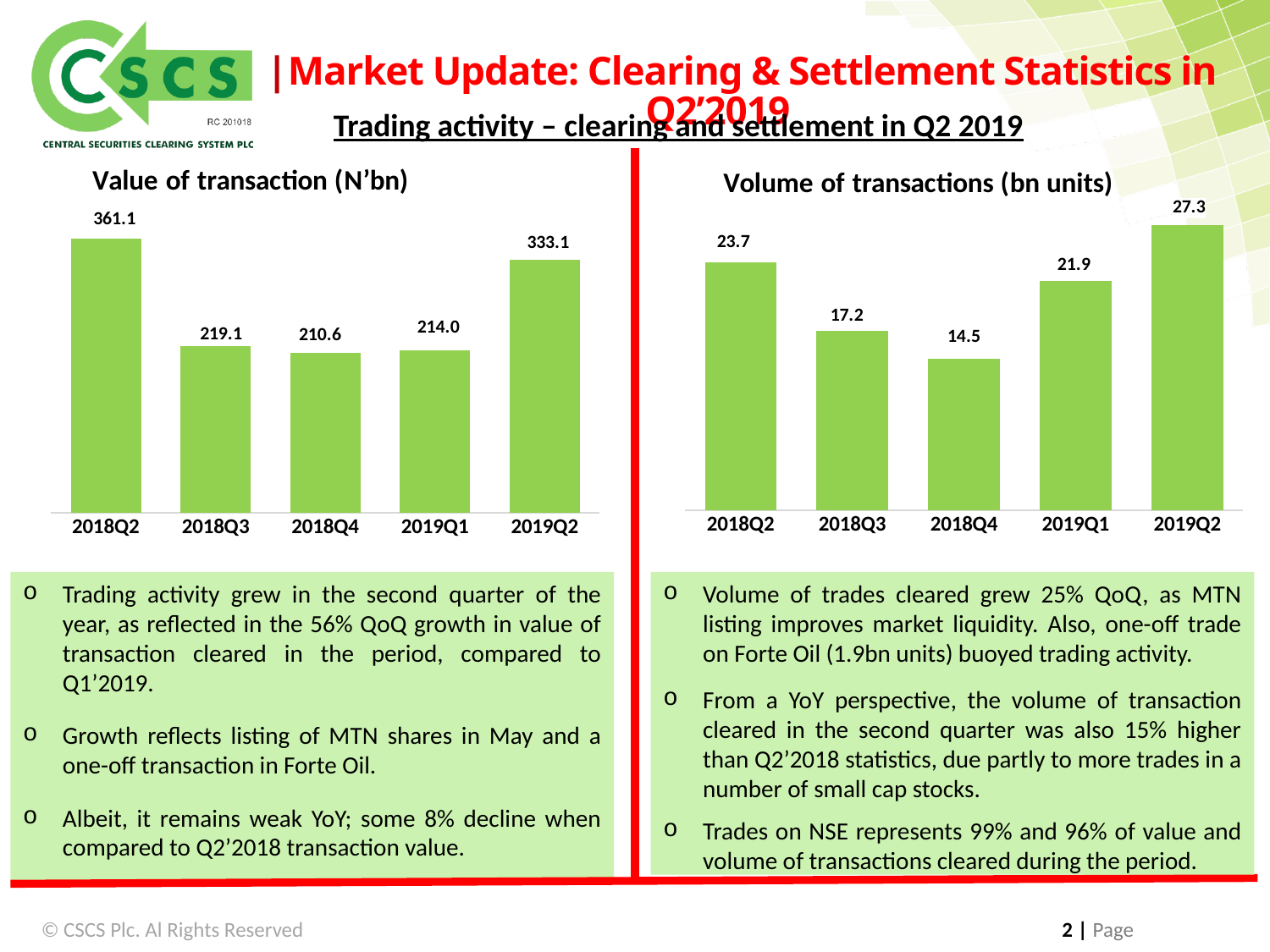
In the 'Value of transaction (N'bn)' chart, which quarter has the lowest value? 2018Q4 In the 'Volume of transactions (bn units)' chart, do the values rise or fall from 2018Q4 to 2019Q2? rise What is the title of the chart on the left side of the slide? Value of transaction (N'bn) In the 'Value of transaction (N'bn)' chart, what is the difference between the 2019Q2 and 2019Q1 values? 119.1 In the 'Value of transaction (N'bn)' chart, how many quarters are shown? 5 In the 'Volume of transactions (bn units)' chart, which quarter has the highest value? 2019Q2 In the 'Value of transaction (N'bn)' chart, is the value for 2018Q2 larger or smaller than the value for 2019Q2? larger In the 'Value of transaction (N'bn)' chart, what is the value for 2018Q2? 361.1 What kind of chart is the 'Volume of transactions (bn units)' chart? bar chart In the 'Volume of transactions (bn units)' chart, what is the difference between the 2019Q2 and 2018Q2 values? 3.6 In the 'Volume of transactions (bn units)' chart, what is the value for 2018Q4? 14.5 In the 'Volume of transactions (bn units)' chart, what is the value for 2019Q1? 21.9